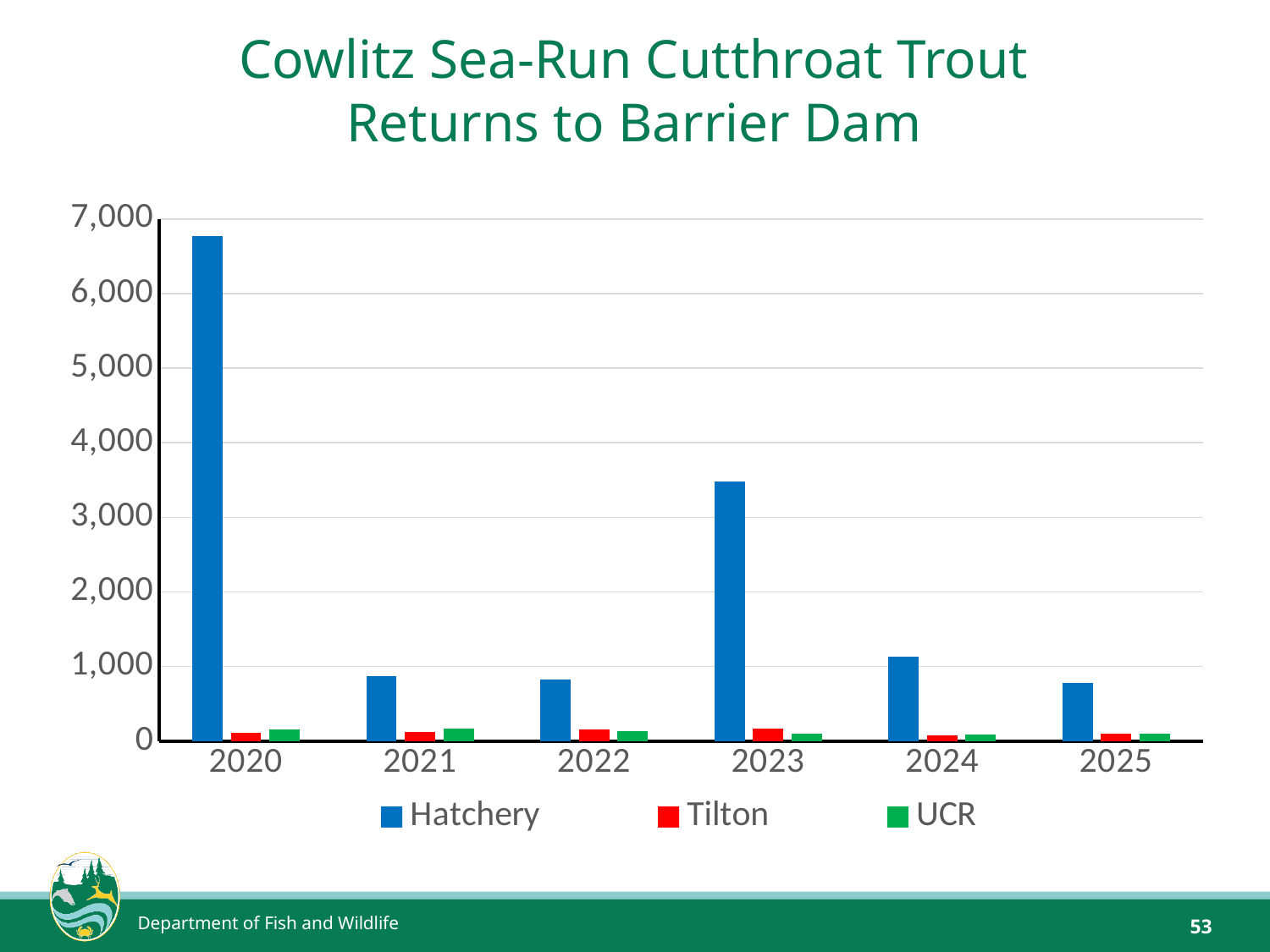
What is the title of the chart? Cowlitz Sea-Run Cutthroat Trout Returns to Barrier Dam Is the Hatchery value for 2023 greater or less than 3,000? greater What kind of chart is shown on the slide? bar chart How many years are shown on the x axis? 6 Is the Hatchery value for 2025 greater or less than 1,000? less In which year is the Hatchery value highest? 2020 Is the Hatchery value for 2021 greater or less than 1,000? less Which is larger, the Hatchery value for 2023 or for 2024? 2023 Which is larger, the Hatchery value for 2020 or for 2023? 2020 What colour represents the Tilton series in the legend? red How many series does the legend list? 3